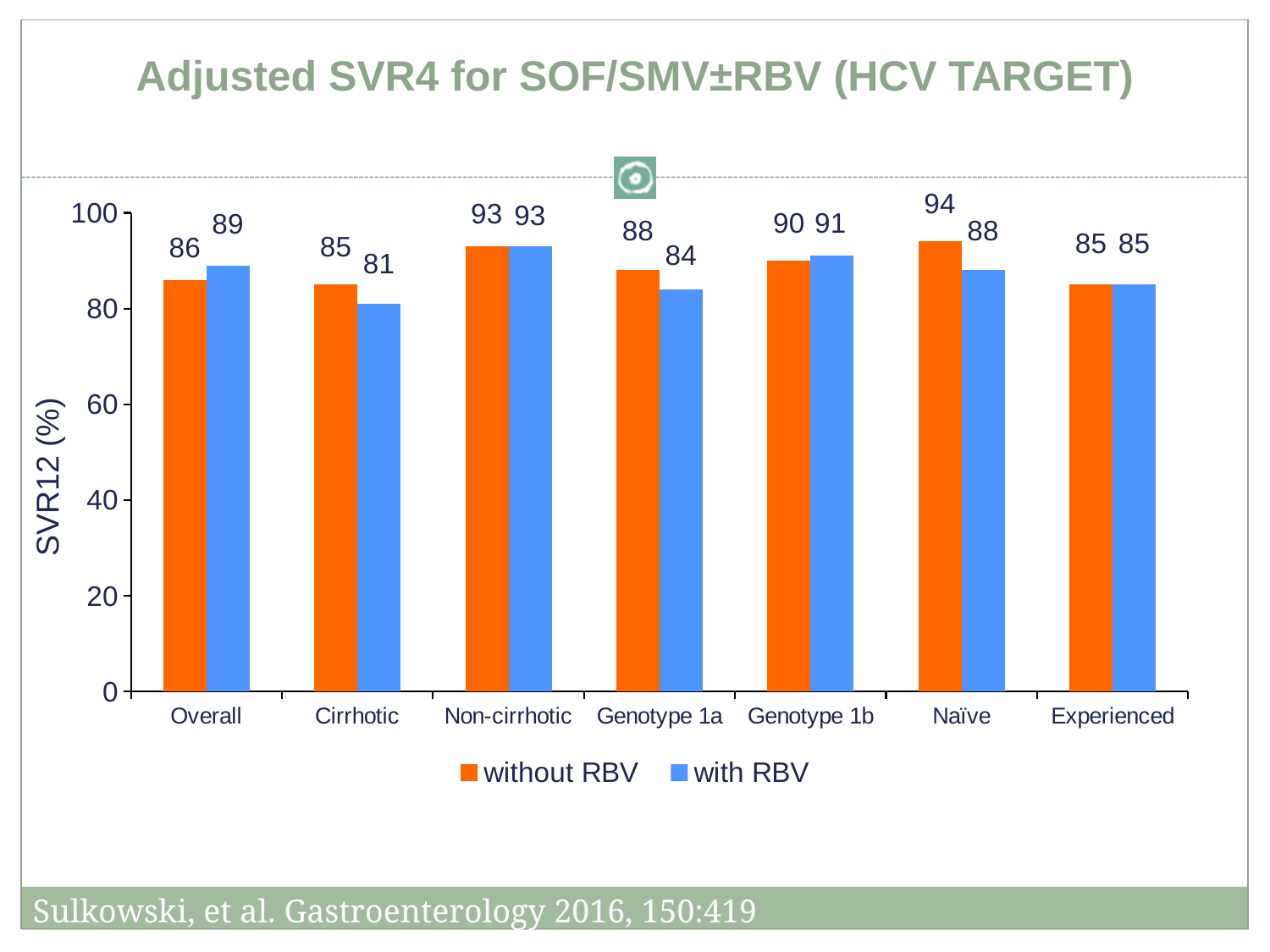
What kind of chart is shown on the slide? Bar chart What is the value for Overall in the 'with RBV' series? 89 Which category has the highest value in the 'without RBV' series? Naïve How many categories are shown on the x axis? 7 What is the label of the y axis? SVR12 (%) How many series does the legend list? 2 What is the difference between the 'without RBV' and 'with RBV' values for Naïve? 6 What is the value for Cirrhotic in the 'without RBV' series? 85 For Genotype 1a, which is larger: the 'without RBV' value or the 'with RBV' value? without RBV Which colour represents the 'with RBV' series? Blue What is the value for Naïve in the 'without RBV' series? 94 Which category has the lowest value in the 'with RBV' series? Cirrhotic